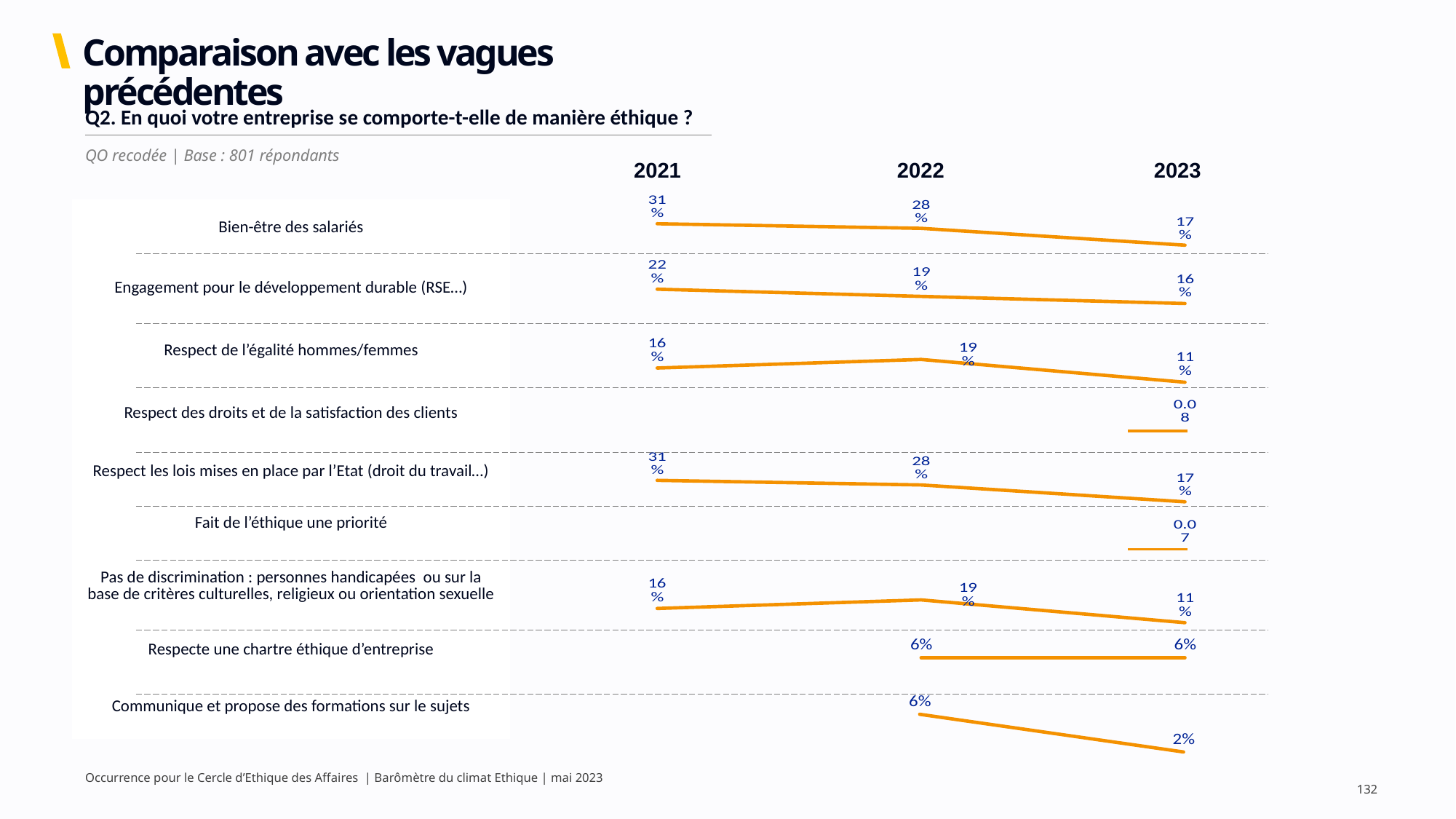
In the 'Engagement pour le développement durable (RSE…)' chart, what is the difference between the 2021 and 2023 values? 6% In the 'Pas de discrimination' chart, which is larger, the 2021 value or the 2022 value? 2022 In the 'Respect de l'égalité hommes/femmes' chart, which year has the highest value? 2022 In the 'Communique et propose des formations sur le sujets' chart, what is the value for 2023? 2% In the 'Respect les lois mises en place par l'Etat (droit du travail…)' chart, do the values rise or fall from 2021 to 2023? fall In the 'Respect les lois mises en place par l'Etat (droit du travail…)' chart, what is the value for 2022? 28% In the 'Bien-être des salariés' chart, what is the value for 2021? 31% In the 'Respect de l'égalité hommes/femmes' chart, which year has the lowest value? 2023 What type of chart is used in each row of the slide? line chart In the 'Bien-être des salariés' chart, what is the value for 2023? 17% In the 'Engagement pour le développement durable (RSE…)' chart, what is the value for 2022? 19% In the 'Respecte une chartre éthique d'entreprise' chart, how many data points are plotted? 2